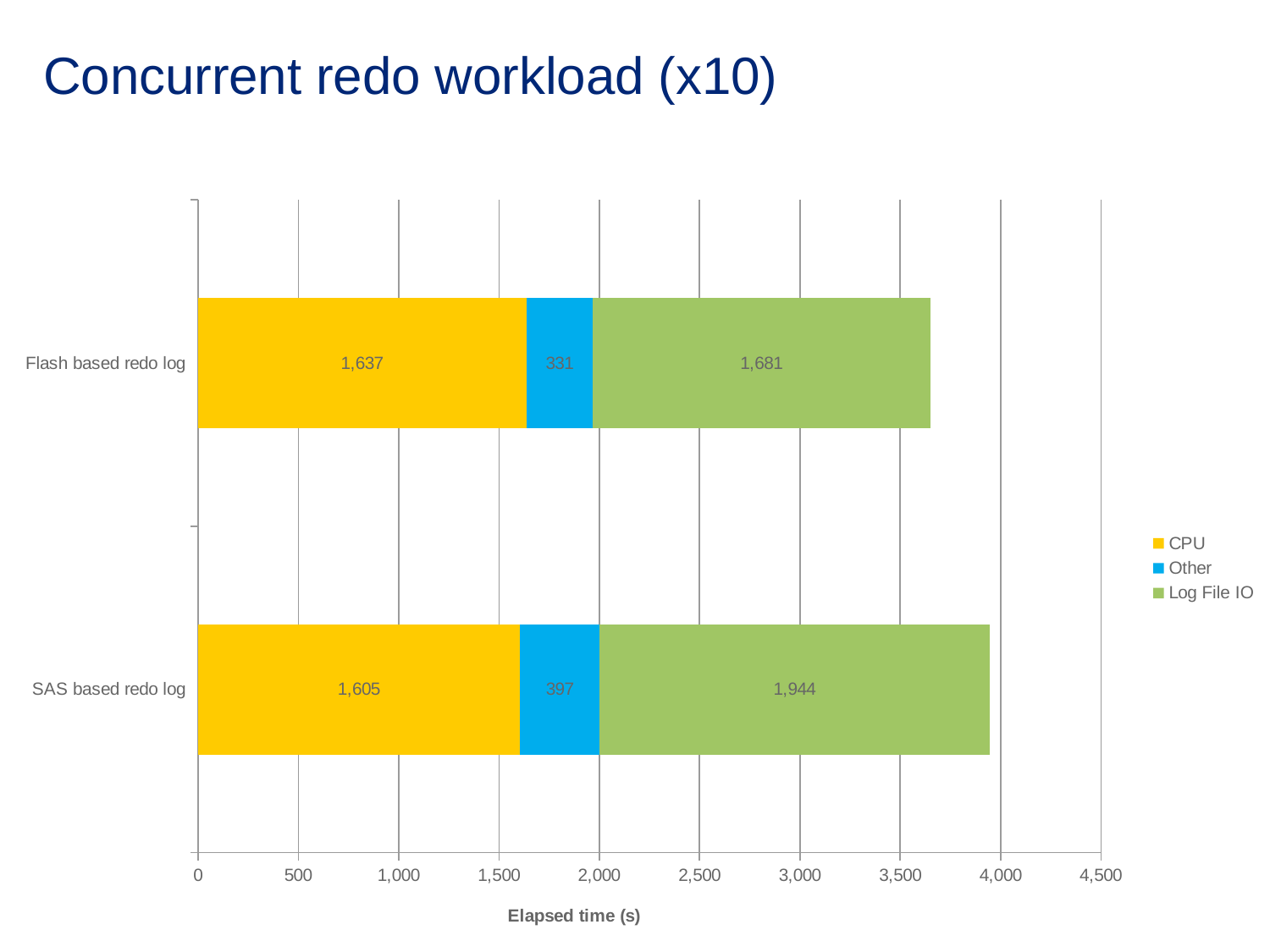
What is the total elapsed time for the Flash based redo log bar? 3,649 What is the Other value for Flash based redo log? 331 Is the Other value larger for Flash based redo log or SAS based redo log? SAS based redo log What is the Log File IO value for SAS based redo log? 1,944 Which category has the higher Log File IO value? SAS based redo log What is the difference in the Other value between SAS based redo log and Flash based redo log? 66 What is the CPU value for SAS based redo log? 1,605 What is the difference in Log File IO between SAS based redo log and Flash based redo log? 263 How many series does the legend list? 3 What kind of chart is shown on the slide? Stacked bar chart What is the CPU value for Flash based redo log? 1,637 What is the total elapsed time for the SAS based redo log bar? 3,946